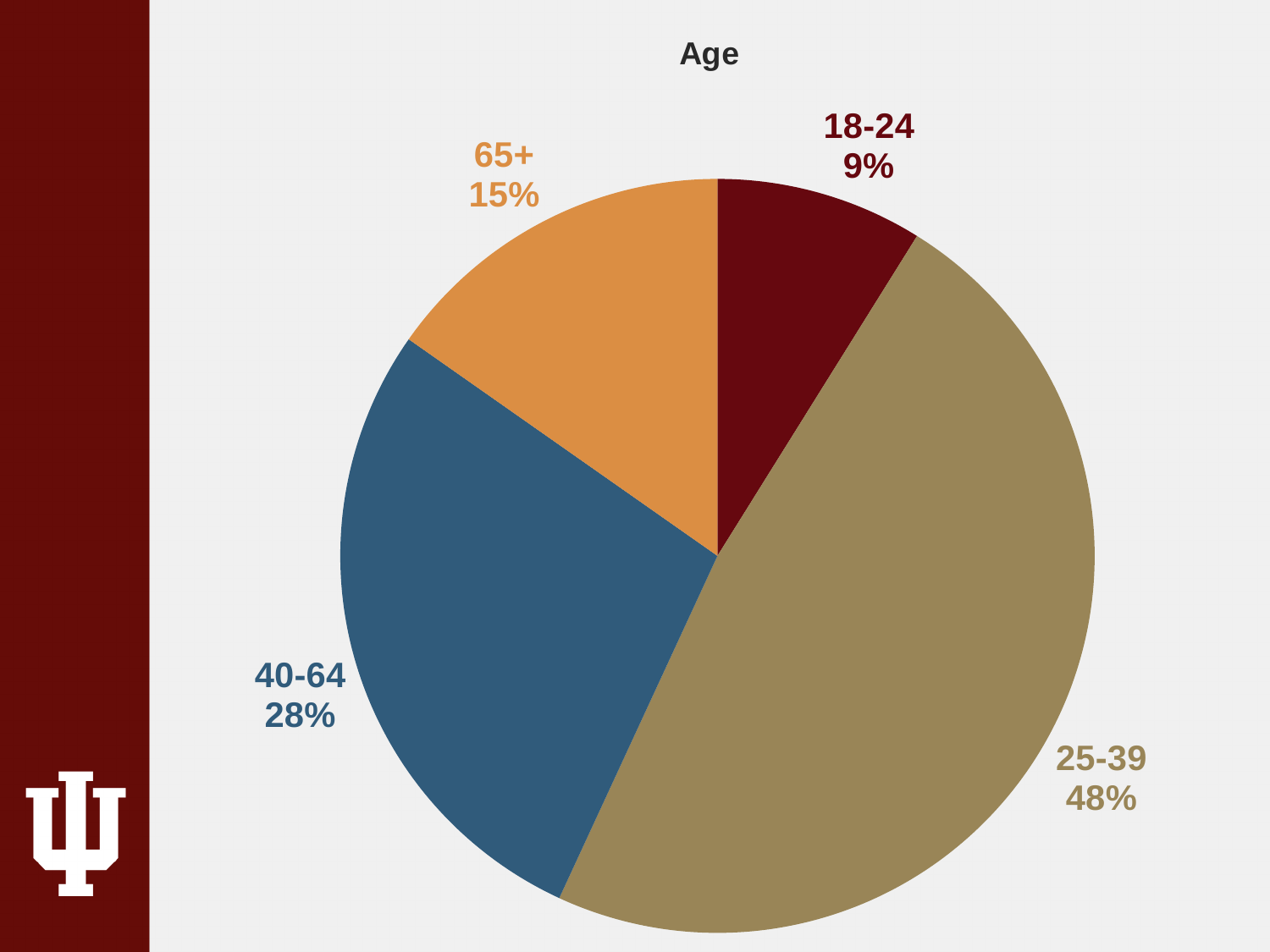
What is the title of the chart? Age How many age groups are shown in the pie chart? 4 What colour is the slice for the 40-64 age group? blue What is the difference in percentage points between the 25-39 and 40-64 age groups? 20 Which age group has the largest share of the pie? 25-39 What percentage of the pie is the 18-24 age group? 9% Which age group has the smallest share of the pie? 18-24 What percentage of the pie is the 40-64 age group? 28% What percentage of the pie is the 25-39 age group? 48% Which age group has a larger share, 65+ or 18-24? 65+ What type of chart is shown on the slide? pie chart What percentage of the pie is the 65+ age group? 15%